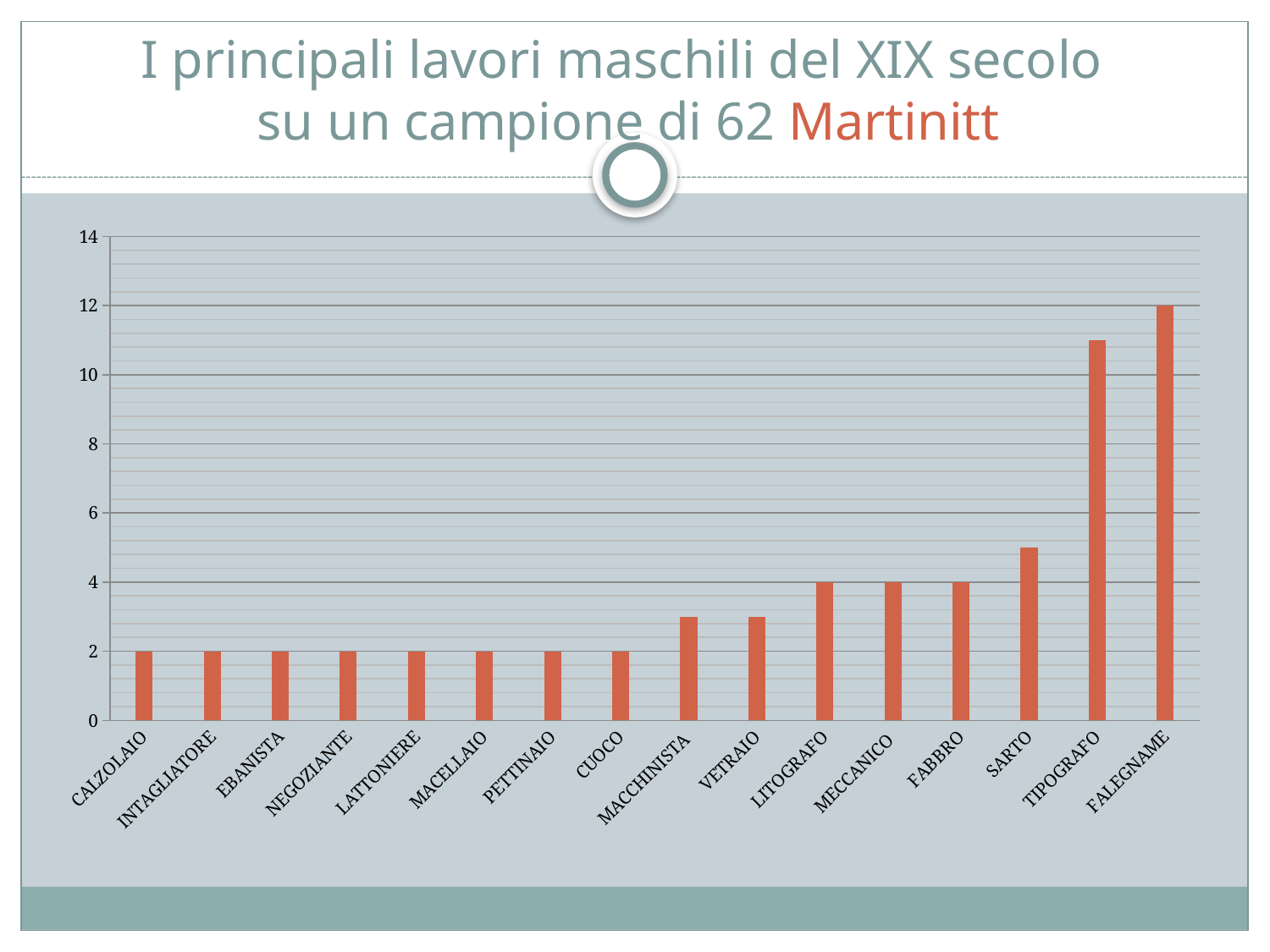
Which has a larger value, TIPOGRAFO or SARTO? TIPOGRAFO What is the value for FALEGNAME? 12 How many categories are shown on the x axis? 16 What kind of chart is shown on the slide? bar chart What is the value for LITOGRAFO? 4 What is the difference between the values for FALEGNAME and CALZOLAIO? 10 What is the value for CALZOLAIO? 2 Do the values generally rise or fall from left to right along the x axis? rise Is the value for MACCHINISTA greater or less than 4? less Which category has the highest value? FALEGNAME Is the value for SARTO greater or less than 4? greater Is the value for TIPOGRAFO greater or less than 10? greater